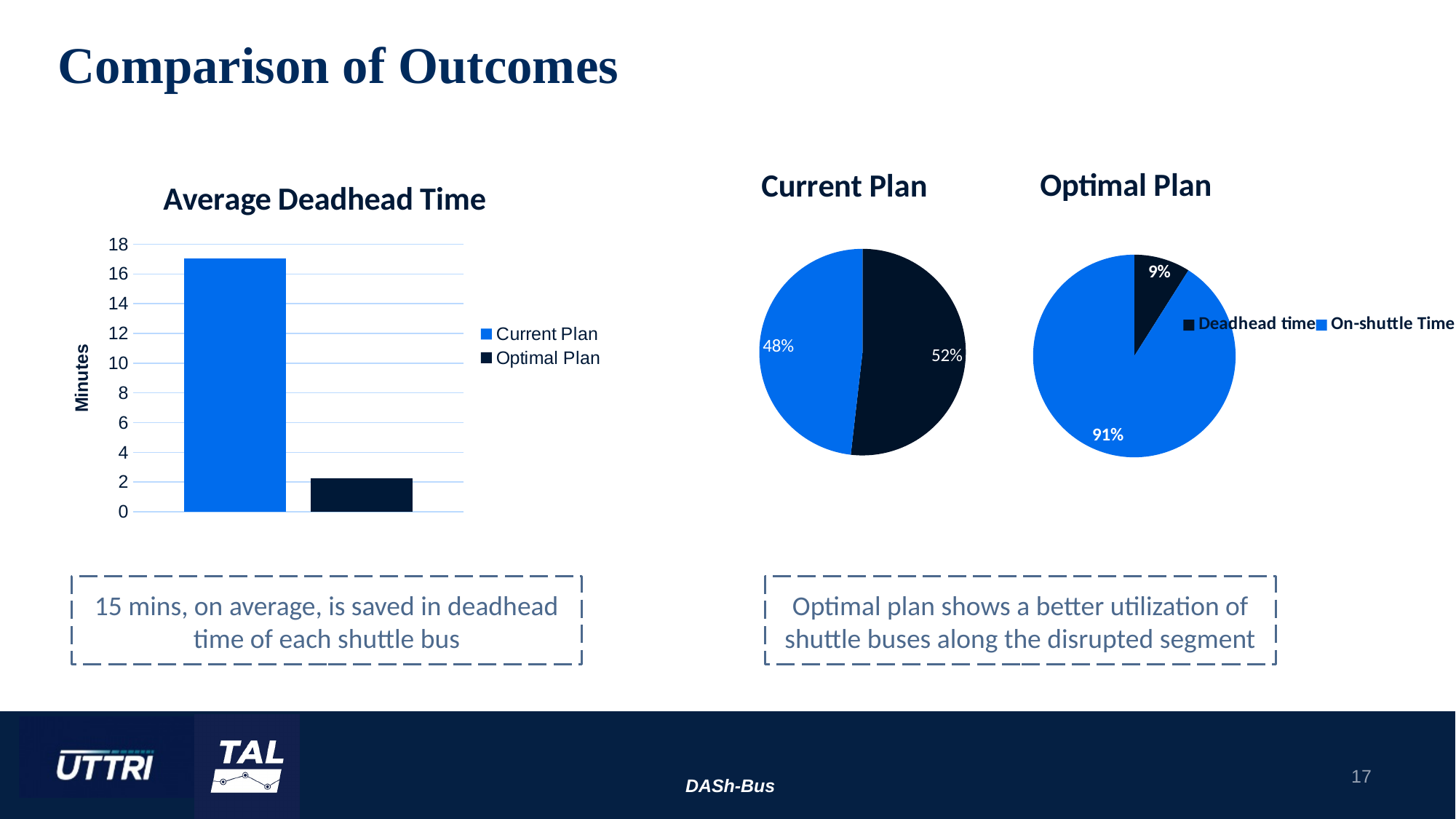
On the Optimal Plan pie chart, what share is Deadhead time? 9% On the Current Plan pie chart, what share is Deadhead time? 52% On the Average Deadhead Time chart, which plan has the lower average deadhead time? Optimal Plan On the Average Deadhead Time chart, is the value for Current Plan greater or less than 10? greater On the Current Plan pie chart, what share is On-shuttle Time? 48% On the Average Deadhead Time chart, what is the label on the vertical axis? Minutes On the Optimal Plan pie chart, what is the difference between the On-shuttle Time share and the Deadhead time share? 82% On the Average Deadhead Time chart, how many series does the legend list? 2 On the Average Deadhead Time chart, which plan has the higher average deadhead time? Current Plan On the Average Deadhead Time chart, what kind of chart is shown? bar chart On the Average Deadhead Time chart, is the value for Optimal Plan greater or less than 4? less